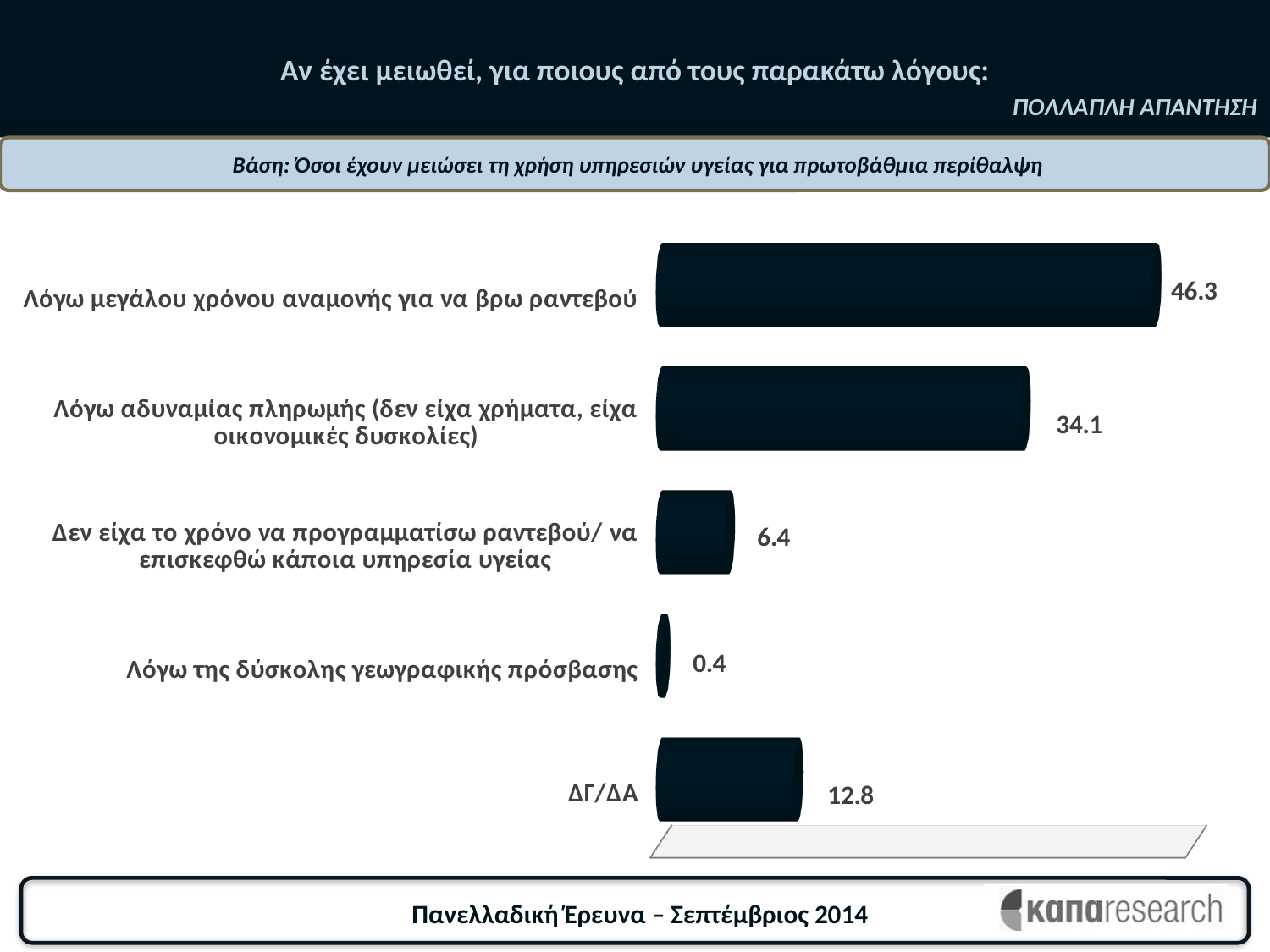
What is the difference between the values for 'ΔΓ/ΔΑ' and 'Δεν είχα το χρόνο να προγραμματίσω ραντεβού/ να επισκεφθώ κάποια υπηρεσία υγείας'? 6.4 Which is larger: the value for 'ΔΓ/ΔΑ' or the value for 'Δεν είχα το χρόνο να προγραμματίσω ραντεβού/ να επισκεφθώ κάποια υπηρεσία υγείας'? ΔΓ/ΔΑ What is the value for 'Λόγω αδυναμίας πληρωμής (δεν είχα χρήματα, είχα οικονομικές δυσκολίες)'? 34.1 What is the difference between the values for 'Λόγω μεγάλου χρόνου αναμονής για να βρω ραντεβού' and 'Λόγω αδυναμίας πληρωμής (δεν είχα χρήματα, είχα οικονομικές δυσκολίες)'? 12.2 What is the value for 'Λόγω της δύσκολης γεωγραφικής πρόσβασης'? 0.4 Which category has the lowest value? Λόγω της δύσκολης γεωγραφικής πρόσβασης What is the value for 'Λόγω μεγάλου χρόνου αναμονής για να βρω ραντεβού'? 46.3 What is the title of the chart on the slide? Αν έχει μειωθεί, για ποιους από τους παρακάτω λόγους: What is the value for 'ΔΓ/ΔΑ'? 12.8 Which category has the highest value? Λόγω μεγάλου χρόνου αναμονής για να βρω ραντεβού How many categories are shown in the chart? 5 What kind of chart is shown on the slide? Bar chart